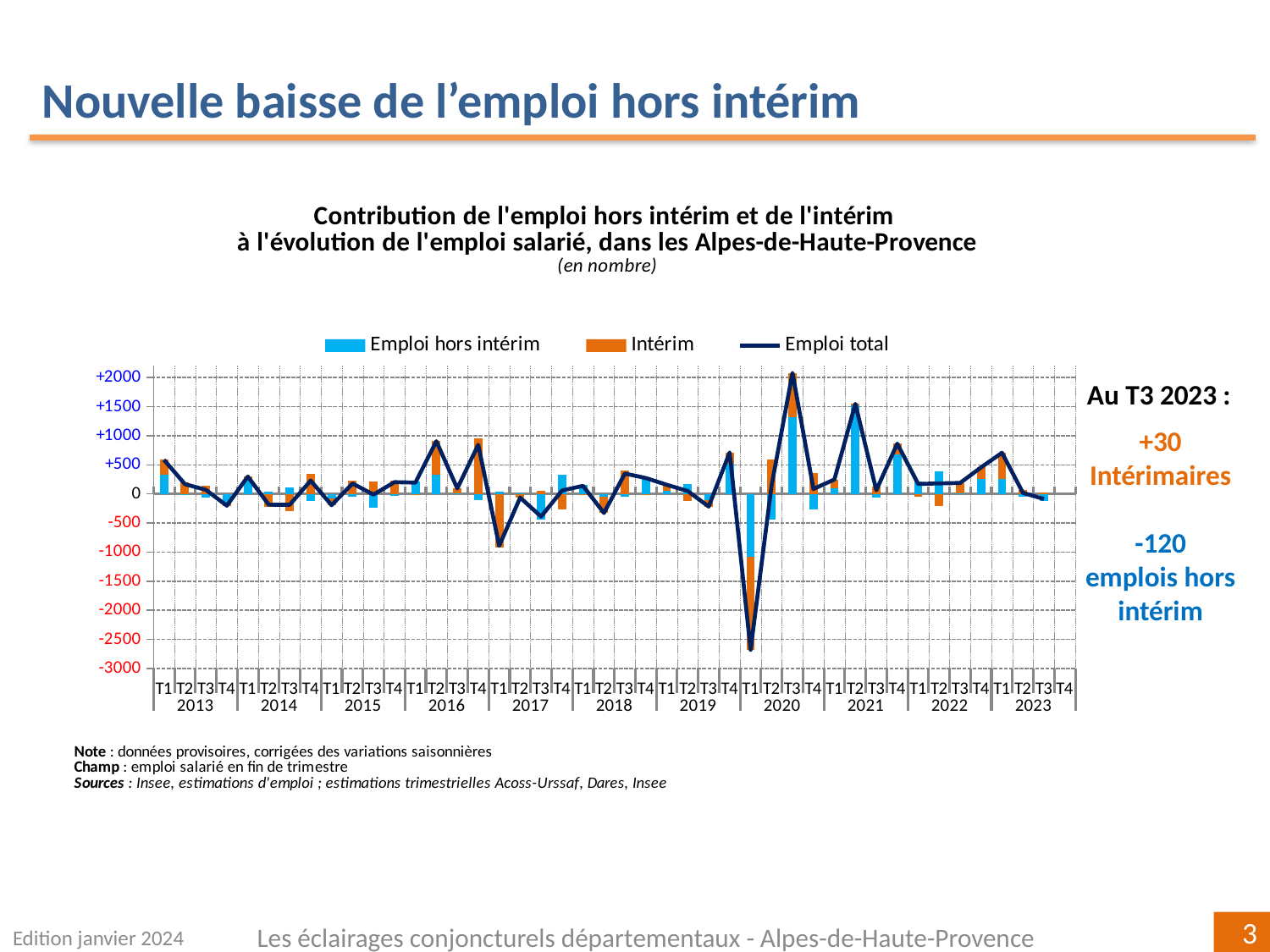
What kind of chart is shown on the slide? A bar chart combined with a line chart What is the title of the chart? Contribution de l'emploi hors intérim et de l'intérim à l'évolution de l'emploi salarié, dans les Alpes-de-Haute-Provence According to the slide, what is the value for Intérim in T3 2023? +30 Is the Emploi total value for T1 2020 greater or less than -2000? less According to the slide, what is the value for Emploi hors intérim in T3 2023? -120 How many years are shown on the x axis of the chart? 11 In which quarter does the Emploi total line reach its highest point? T3 2020 What is the total of the Intérim and Emploi hors intérim contributions in T3 2023? -90 How many series does the chart legend list? 3 Is the Emploi total value for T2 2021 greater or less than +1000? greater Which is larger, the Emploi total value in T3 2020 or in T2 2021? T3 2020 In which quarter does the Emploi total line reach its lowest point? T1 2020